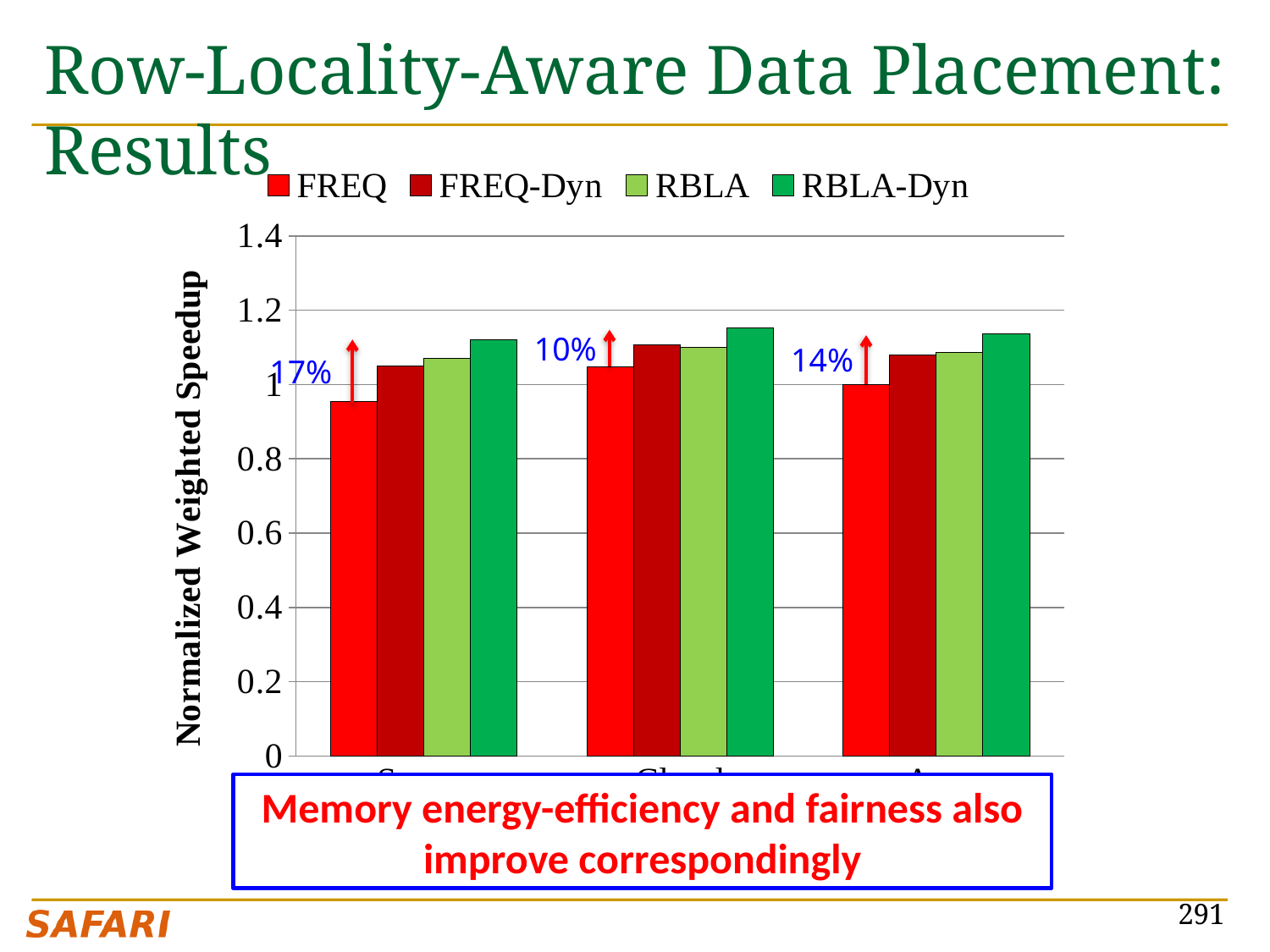
What are the series names listed in the legend? FREQ, FREQ-Dyn, RBLA, RBLA-Dyn What percentage improvement is annotated above the leftmost group of bars? 17% Is the RBLA-Dyn value in the middle group of bars greater or less than 1.2? less Is the FREQ value in the leftmost group of bars greater or less than 1? less How many groups of bars are plotted in the chart? 3 What percentage improvement is annotated above the middle group of bars? 10% In the leftmost group of bars, which series has the highest value? RBLA-Dyn What percentage improvement is annotated above the rightmost group of bars? 14% What is the title of the vertical axis? Normalized Weighted Speedup How many series does the legend list? 4 In the leftmost group of bars, which is larger, FREQ or RBLA-Dyn? RBLA-Dyn What kind of chart is shown on the slide? bar chart